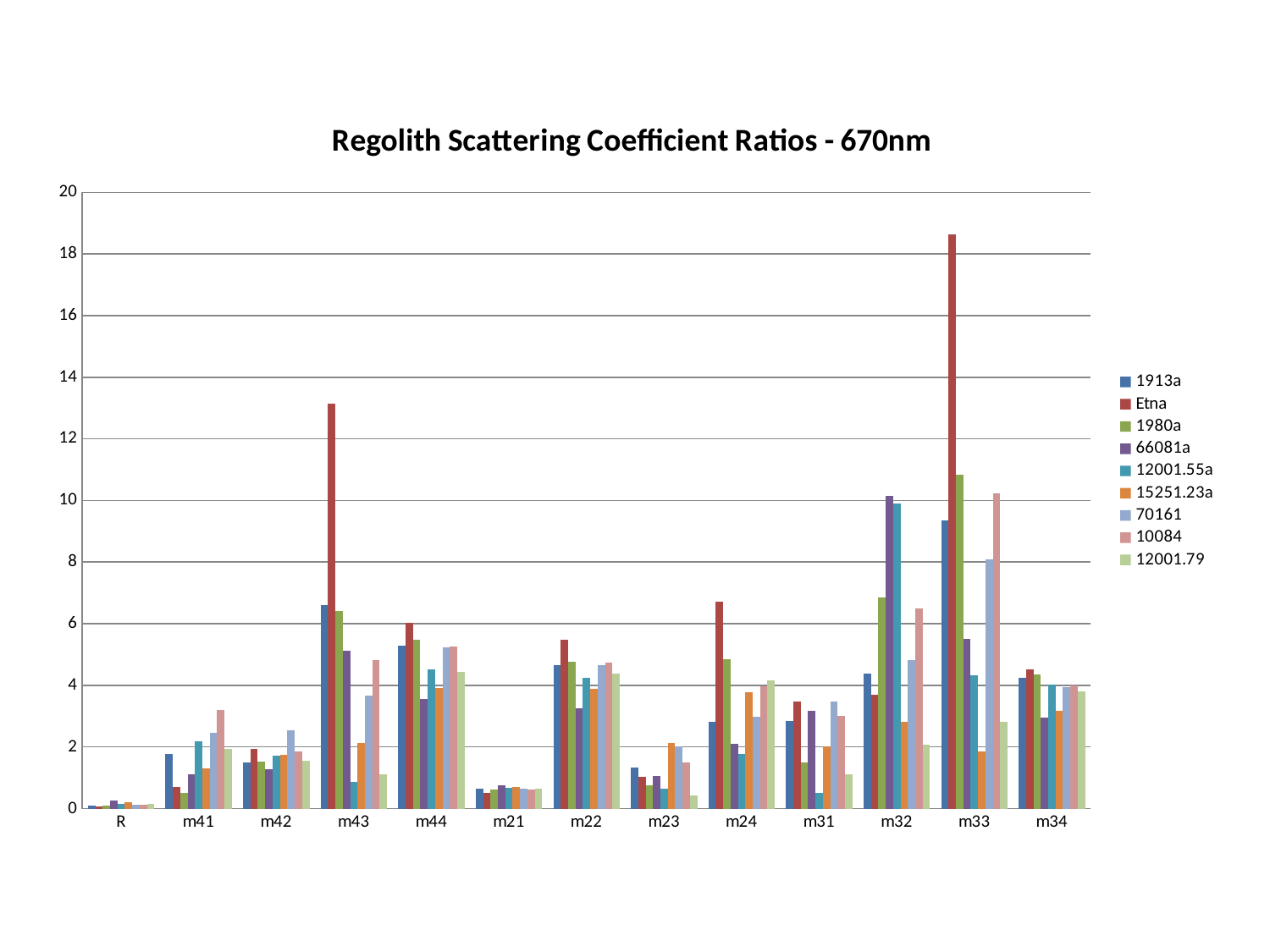
Is the Etna value for m43 greater or less than 12? greater In which category does the Etna series reach its highest value? m33 Is the 12001.55a value for m43 greater or less than 2? less Is the Etna value for m33 greater or less than 18? greater Which series has the tallest bar in the m33 group? Etna What kind of chart is shown on the slide? bar chart What is the title of the chart? Regolith Scattering Coefficient Ratios - 670nm How many series does the legend list? 9 How many categories are shown on the x axis? 13 Which series has the tallest bar in the m43 group? Etna In the m32 group, which is larger: the 1980a bar or the 1913a bar? 1980a